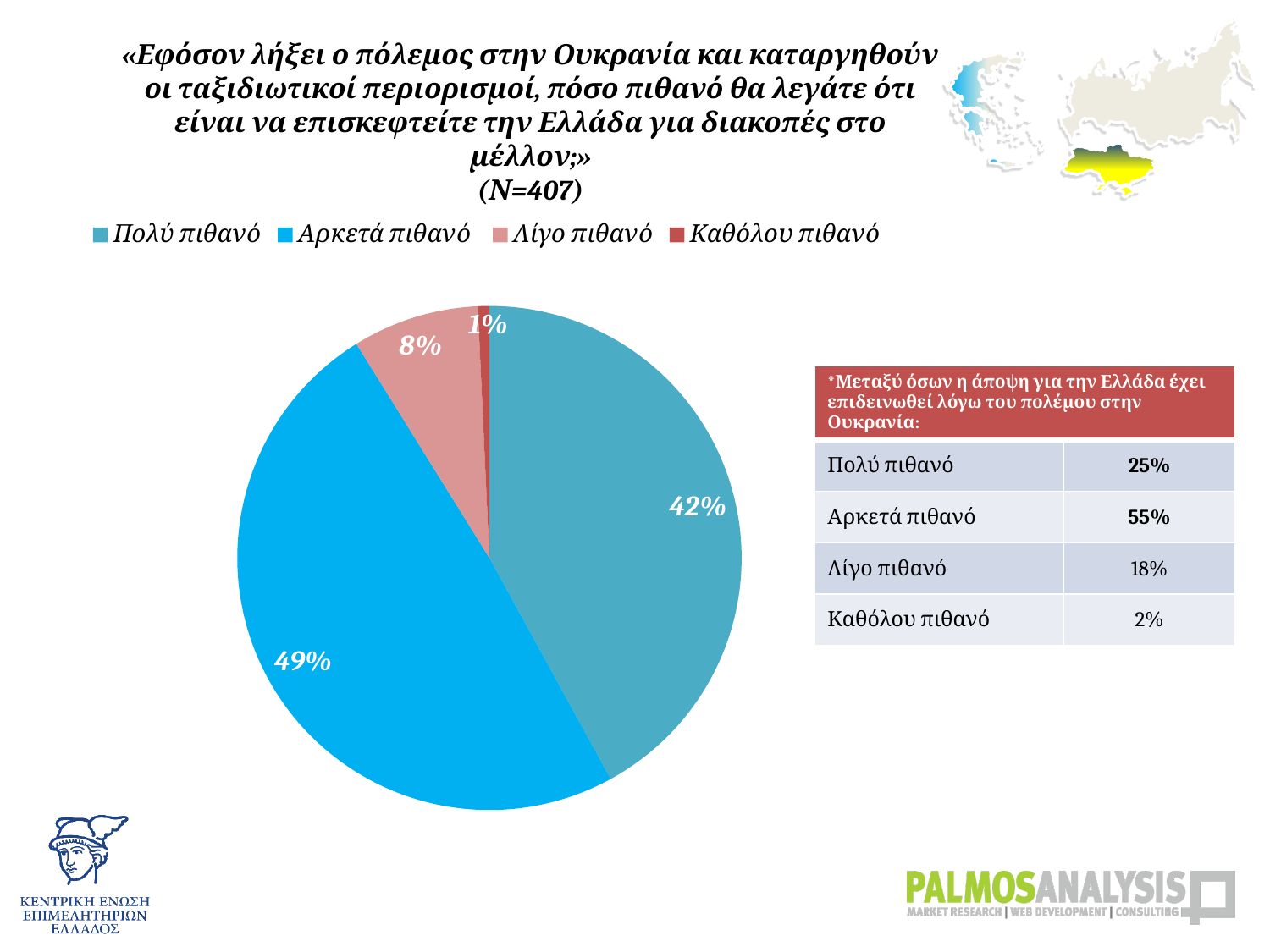
What share of the pie does "Αρκετά πιθανό" have? 49% What sample size (N) is stated in the chart title? N=407 What share of the pie does "Πολύ πιθανό" have? 42% Which category has the smallest slice of the pie? Καθόλου πιθανό How many slices does the pie chart have? 4 What is the value shown for "Λίγο πιθανό" in the pie chart? 8% Which is larger in the pie chart, "Λίγο πιθανό" or "Καθόλου πιθανό"? Λίγο πιθανό How many entries does the legend list? 4 What is the value shown for "Καθόλου πιθανό" in the pie chart? 1% What kind of chart is shown on the slide? Pie chart Which category has the largest slice of the pie? Αρκετά πιθανό What is the difference between the "Αρκετά πιθανό" and "Πολύ πιθανό" slices? 7%